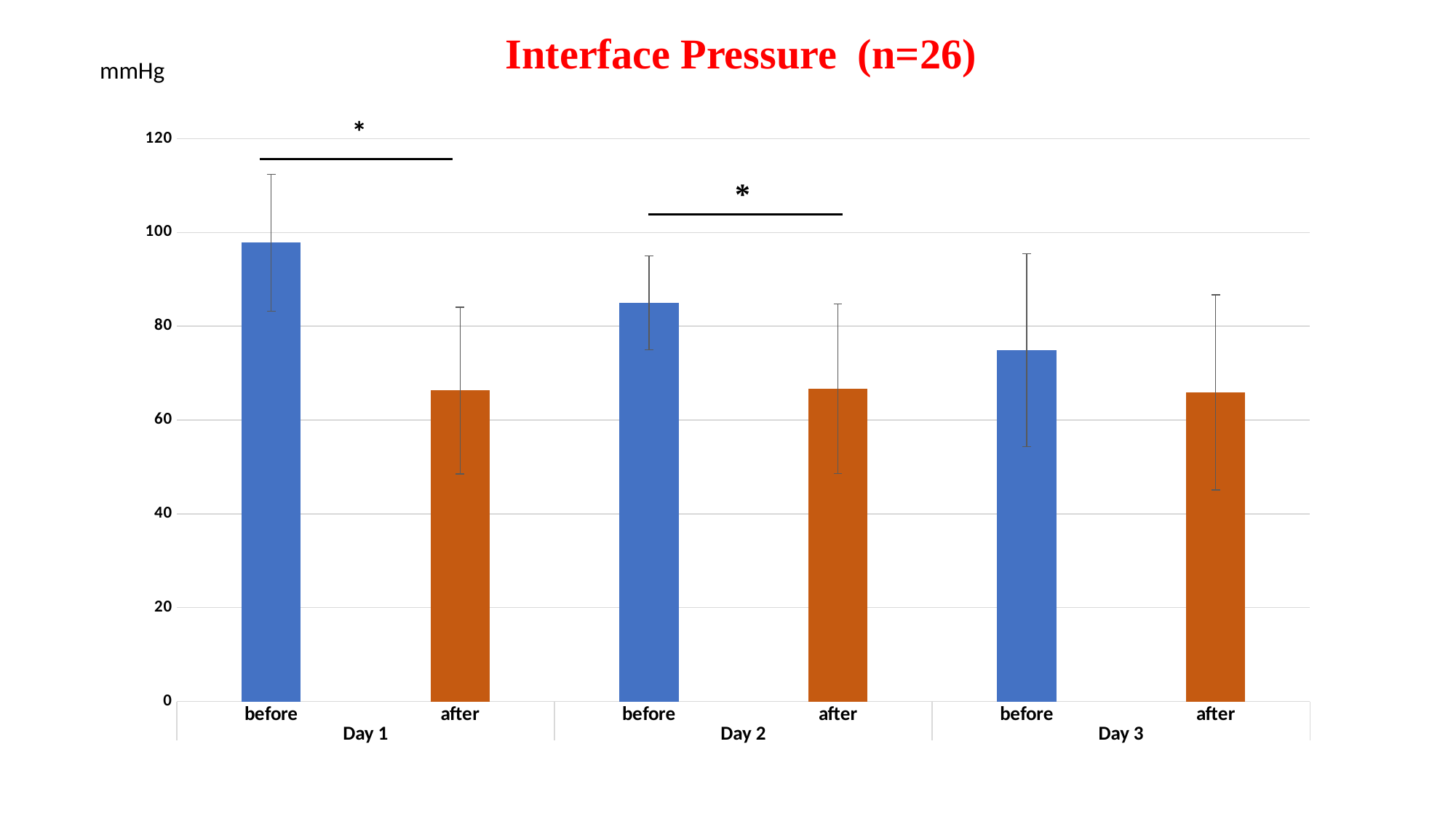
What unit is shown on the vertical axis of the chart? mmHg How many bars are plotted in the chart? 6 What is the title of the chart? Interface Pressure (n=26) Do the 'before' values rise or fall from Day 1 to Day 3? fall Is the value for Day 1 before greater or less than 80? greater Is the value for Day 3 before greater or less than 60? greater Is the value for Day 1 after greater or less than 80? less What kind of chart is shown on the slide? bar chart Which is larger, the value for Day 1 before or the value for Day 1 after? Day 1 before Which bar has the highest value in the chart? Day 1 before How many day groups are shown on the x axis? 3